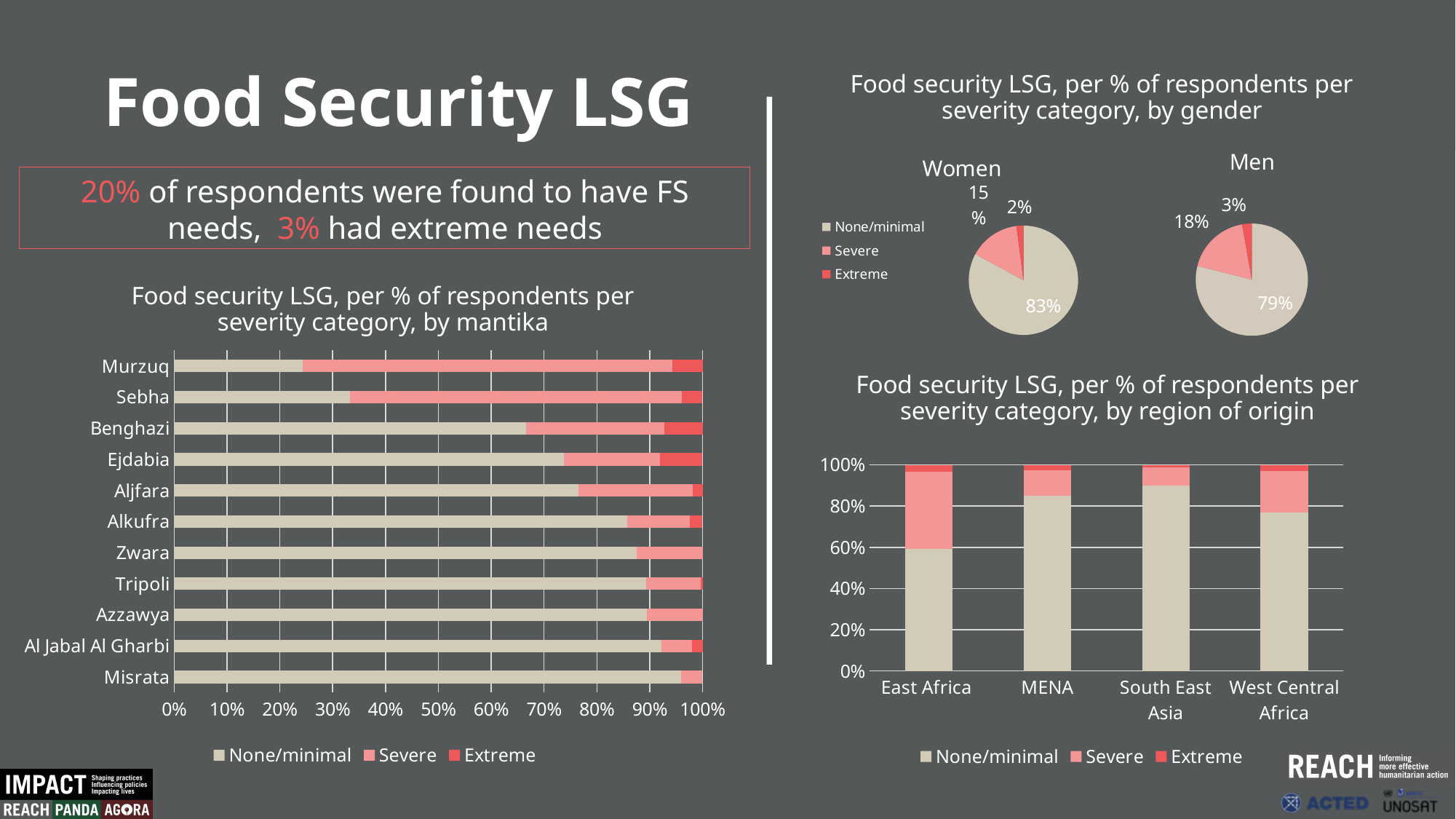
In the chart by mantika, how many mantikas are shown? 11 In the chart by region of origin, which region has the lowest None/minimal share? East Africa In the chart by mantika, is the None/minimal value for Murzuq greater or less than 30%? less In the pie charts by gender, what percentage of women fall in the Severe category? 15% In the pie charts by gender, what percentage of men fall in the Extreme category? 3% What kind of chart is the chart by mantika? Stacked bar chart In the pie charts by gender, what percentage of women fall in the None/minimal category? 83% In the pie charts by gender, how many percentage points higher is the Severe share for men than for women? 3% In the chart by mantika, which mantika has the smallest None/minimal share? Murzuq In the pie charts by gender, which group has the larger None/minimal share, women or men? Women In the chart by mantika, how many series does the legend list? 3 In the pie charts by gender, what percentage of men fall in the Severe category? 18%